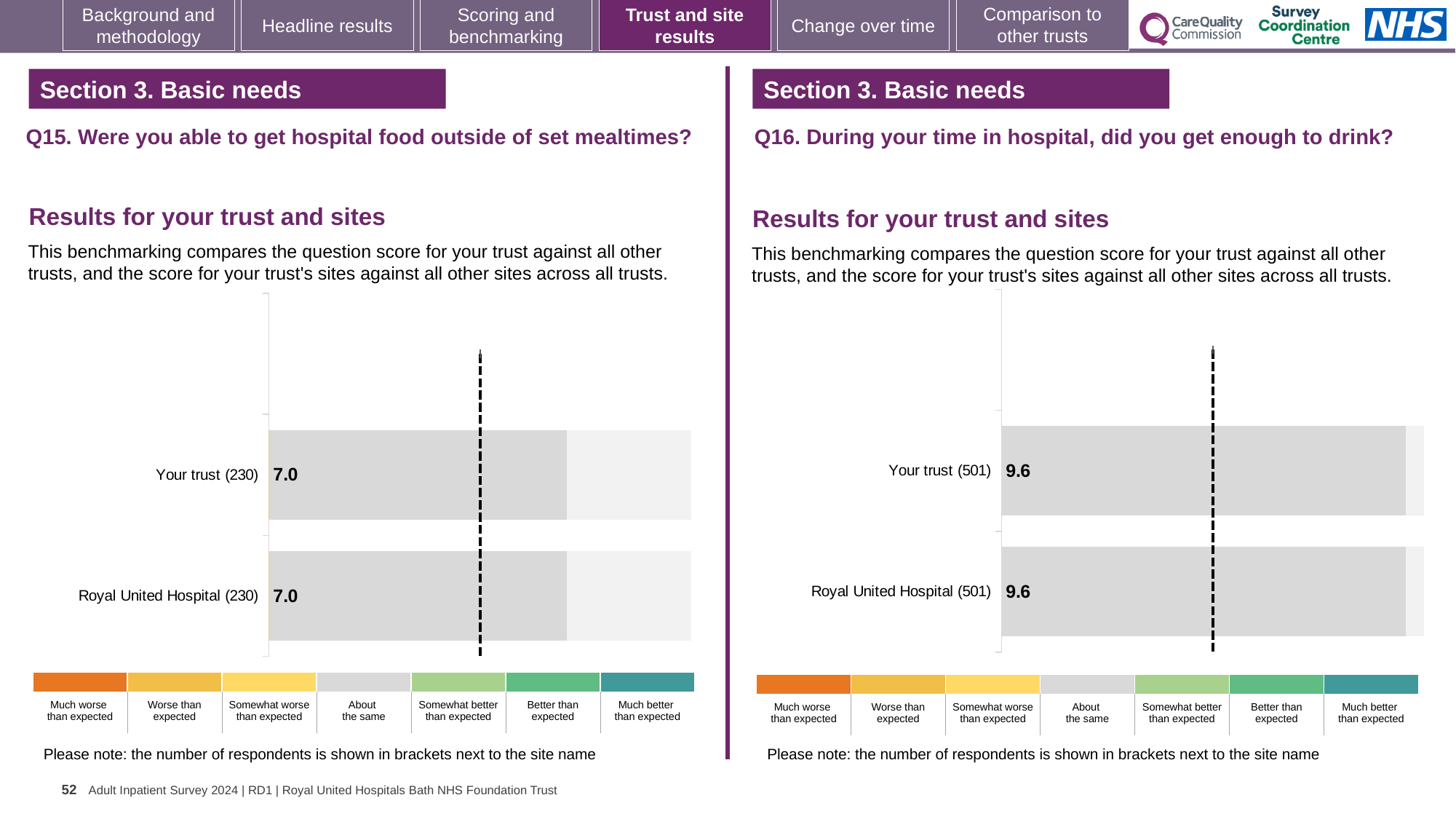
What kind of chart is the Q16 chart (right)? Bar chart What kind of chart is the Q15 chart (left)? Bar chart On the Q16 chart (right), what is the score for Royal United Hospital (501)? 9.6 On the Q15 chart (left), what is the score for Royal United Hospital (230)? 7.0 On the Q16 chart (right), what is the score for Your trust (501)? 9.6 Is the score for Your trust on the Q16 chart (right) larger or smaller than the score for Your trust on the Q15 chart (left)? Larger On the Q15 chart (left), how many bars are plotted? 2 On the Q15 chart (left), what is the score for Your trust (230)? 7.0 What is the difference between the Your trust score on the Q16 chart (right) and the Your trust score on the Q15 chart (left)? 2.6 On the Q16 chart (right), how many bars are plotted? 2 How many categories does the colour key below the Q16 chart (right) list? 7 On the Q15 chart (left), how many respondents are shown in brackets next to Royal United Hospital? 230